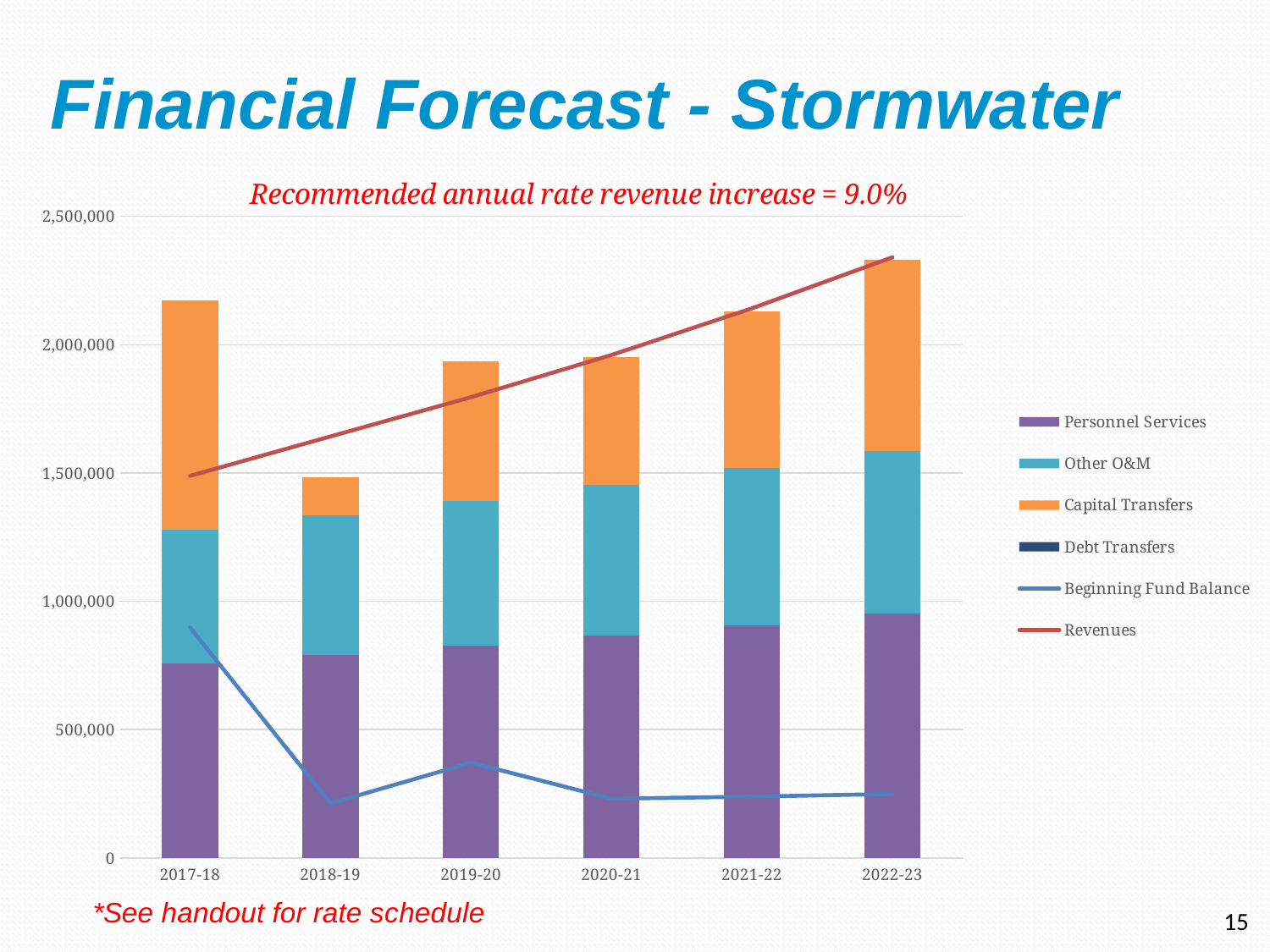
Which series is shown in orange in the stacked bars? Capital Transfers Is the Revenues value for 2022-23 greater or less than 2,000,000? greater How many fiscal years are shown along the x axis? 6 Is the Beginning Fund Balance for 2018-19 greater or less than 500,000? less Which year has the lowest total stacked bar? 2018-19 Is the total stacked bar for 2017-18 greater or less than 2,000,000? greater Which is larger in 2017-18: the Beginning Fund Balance or the Beginning Fund Balance in 2018-19? 2017-18 What kind of chart is shown on the slide? Stacked bar chart with line series How many series does the legend list? 6 Which year has the highest total stacked bar? 2022-23 Do Revenues rise or fall from 2017-18 to 2022-23? Rise What is the recommended annual rate revenue increase stated in the chart title? 9.0%